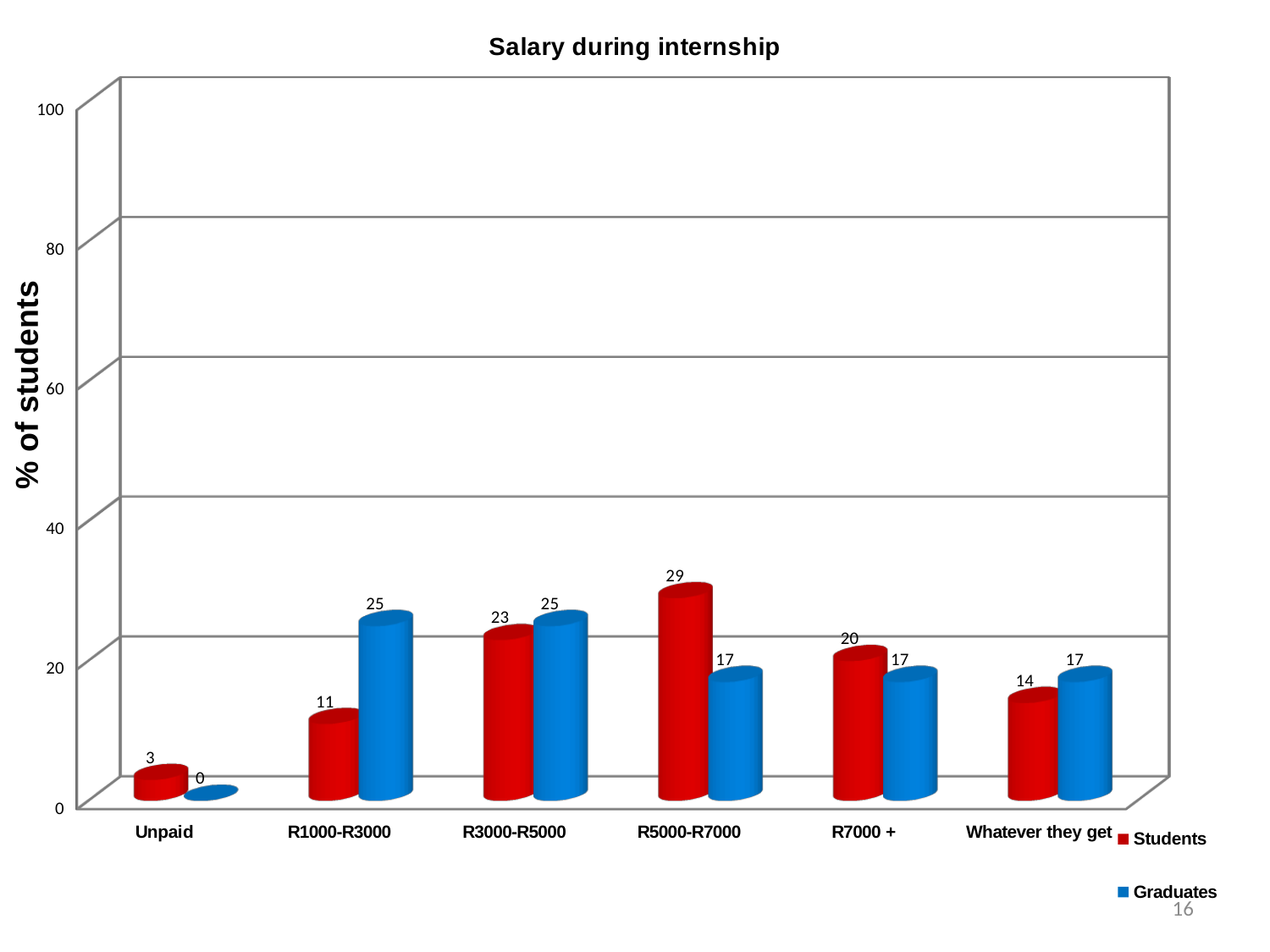
What is the title of the chart? Salary during internship Is the value for Students in the R3000-R5000 category greater or less than 20? greater How many salary categories are shown on the x axis? 6 What kind of chart is shown on the slide? Bar chart What is the value for Students in the R5000-R7000 category? 29 What is the value for Graduates in the R1000-R3000 category? 25 What is the value for Graduates in the Unpaid category? 0 What is the difference between Students and Graduates in the R5000-R7000 category? 12 In the R1000-R3000 category, which is larger, Students or Graduates? Graduates How many series does the legend list? 2 Which category has the highest value for Students? R5000-R7000 Which category has the lowest value for Graduates? Unpaid